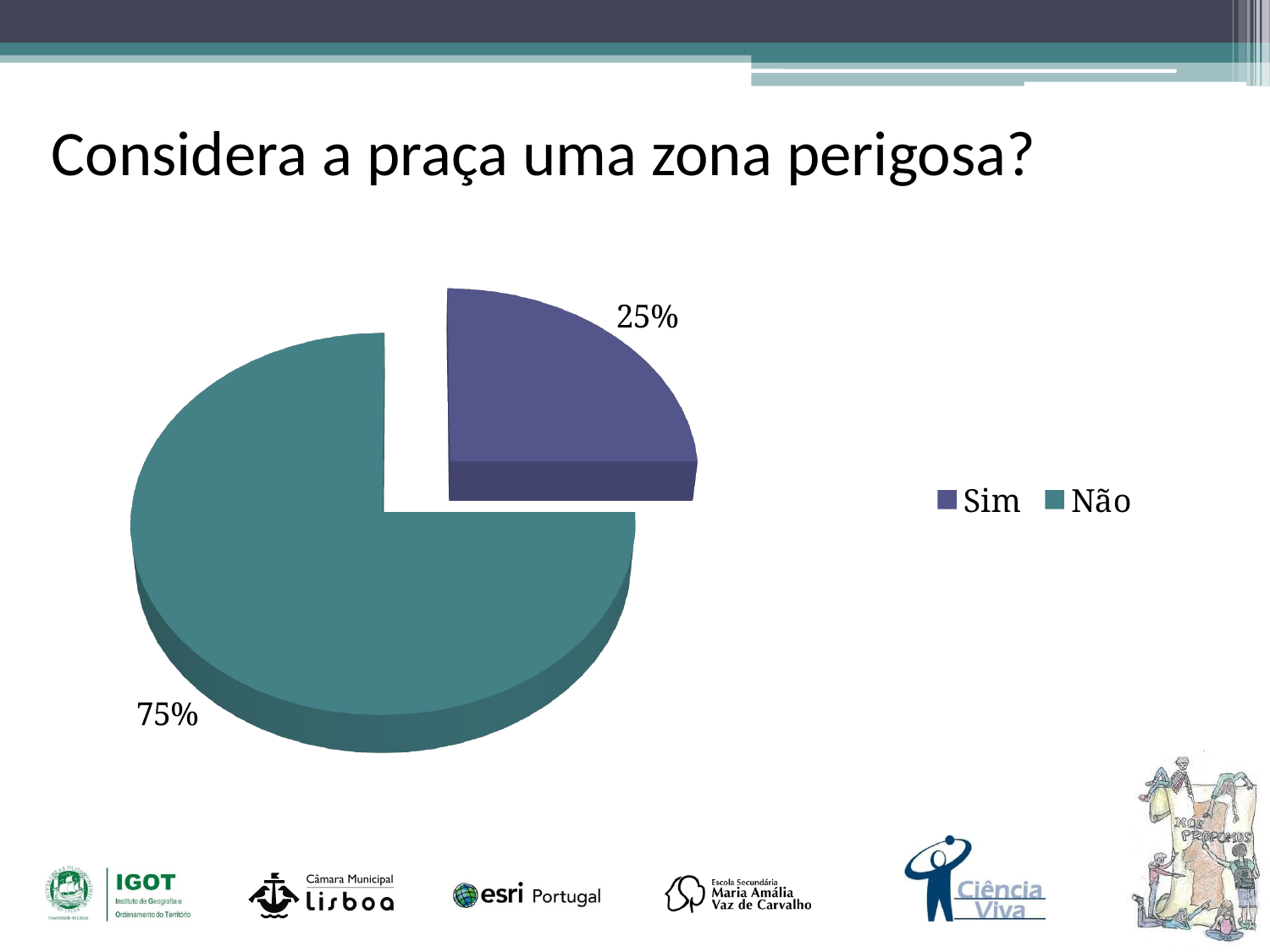
What is the difference in percentage points between the "Não" and "Sim" slices? 50 What percentage of respondents answered "Não"? 75% What kind of chart is shown on the slide? pie chart Which is larger, the share for "Sim" or the share for "Não"? Não Which legend entry is shown in purple? Sim Which response has the largest share of the pie? Não Which response has the smallest share of the pie? Sim What is the title of the slide containing the chart? Considera a praça uma zona perigosa? What percentage of respondents answered "Sim"? 25% What share of the pie does the "Não" slice represent? 75% How many slices does the pie chart have? 2 How many entries does the legend list? 2